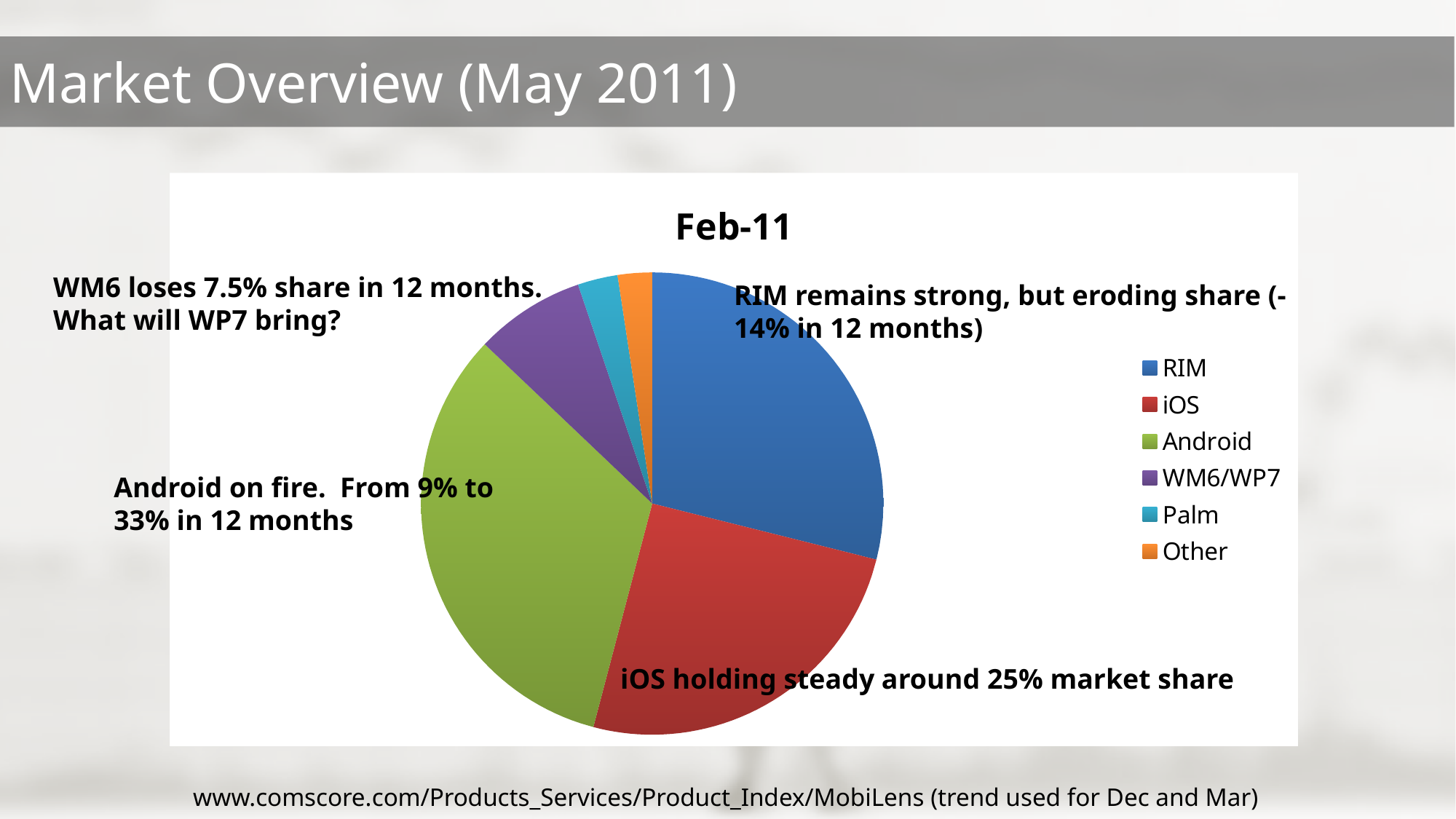
Which category has the largest slice in the pie chart? Android What kind of chart is shown on the slide? pie chart How many slices does the pie chart have? 6 Which slice is larger, RIM or Palm? RIM Which slice is larger, Android or WM6/WP7? Android Which slice is larger, iOS or Other? iOS What colour is the Android slice in the pie chart? green What is the title of the pie chart? Feb-11 How many entries does the legend of the pie chart list? 6